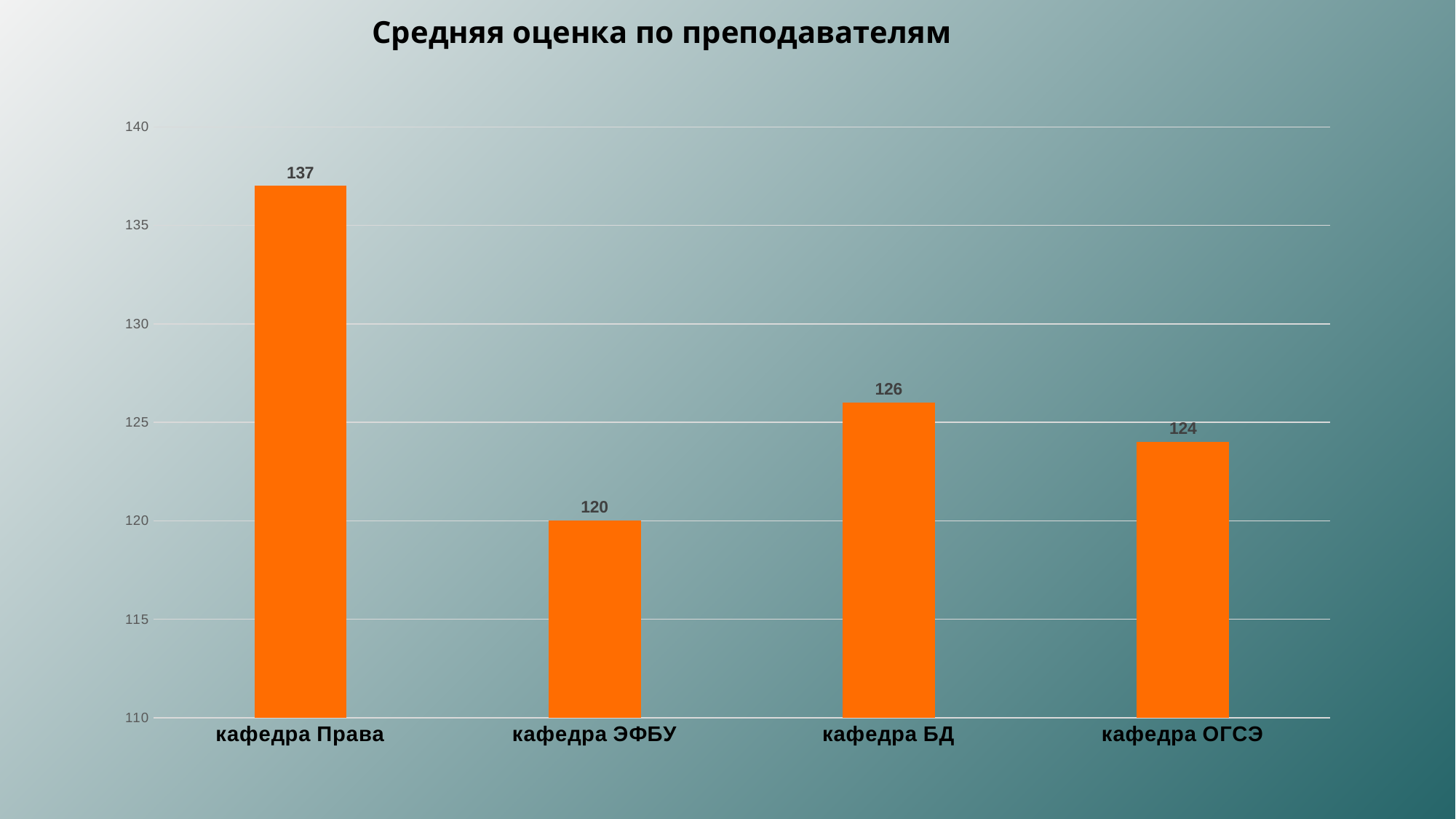
How many categories are shown on the chart? 4 What is the difference between the values for кафедра Права and кафедра ЭФБУ? 17 What is the value for кафедра ОГСЭ? 124 What is the value for кафедра Права? 137 What is the difference between the values for кафедра БД and кафедра ОГСЭ? 2 Is the value for кафедра Права greater or less than 135? greater What is the value for кафедра ЭФБУ? 120 Which category has the highest value? кафедра Права Which category has the lowest value? кафедра ЭФБУ What is the title of the chart? Средняя оценка по преподавателям Which is larger, the value for кафедра БД or the value for кафедра ОГСЭ? кафедра БД What is the value for кафедра БД? 126